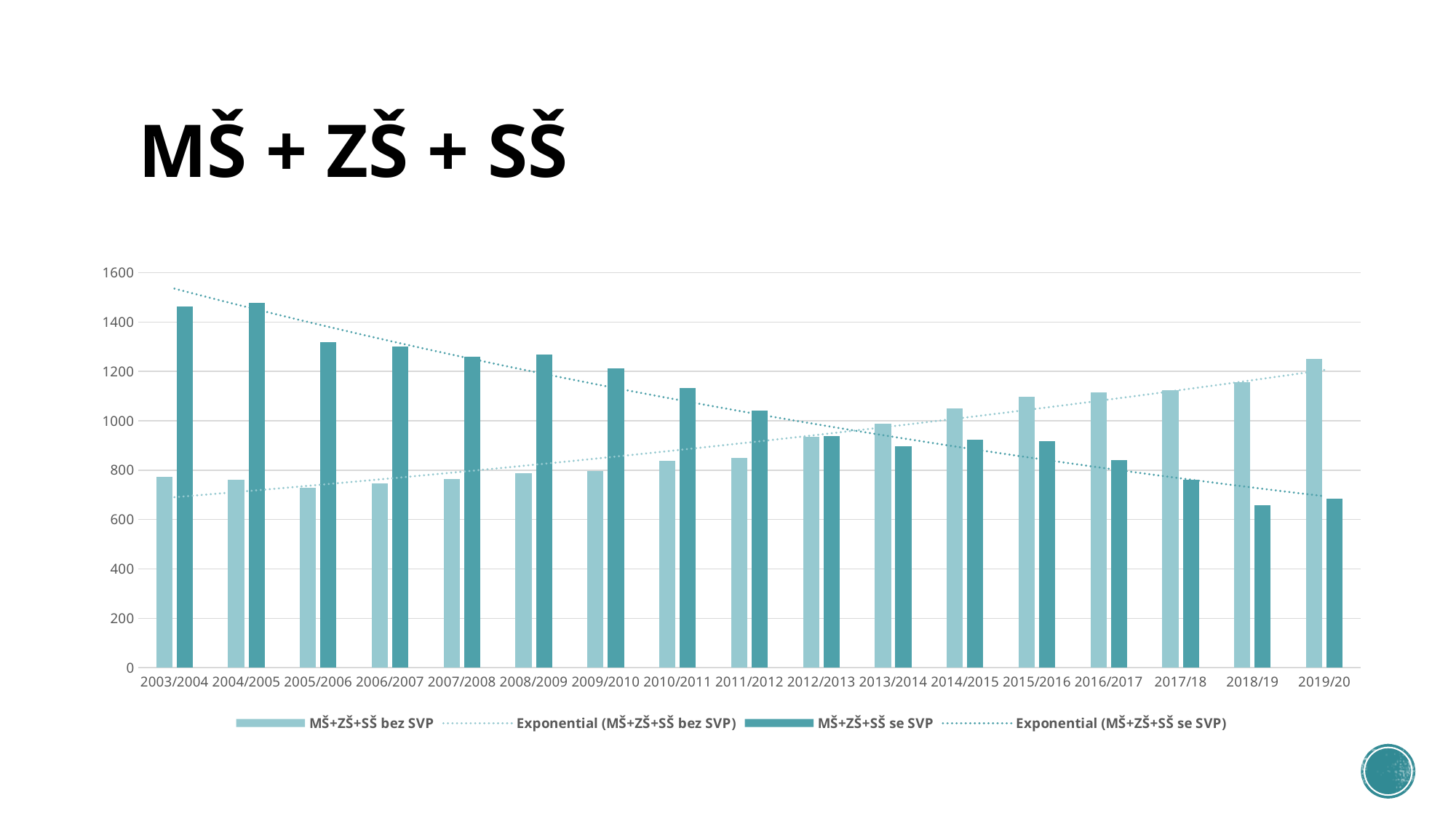
Which school year has the highest value for MŠ+ZŠ+SŠ bez SVP? 2019/20 Is the value for MŠ+ZŠ+SŠ bez SVP in 2014/2015 greater or less than 1000? greater How many entries does the legend list? 4 What kind of chart is shown on the slide? bar chart Do the values for MŠ+ZŠ+SŠ se SVP generally rise or fall from 2003/2004 to 2019/20? fall Is the value for MŠ+ZŠ+SŠ se SVP in 2018/19 greater or less than 800? less In 2003/2004, which series has the larger value: MŠ+ZŠ+SŠ bez SVP or MŠ+ZŠ+SŠ se SVP? MŠ+ZŠ+SŠ se SVP Is the value for MŠ+ZŠ+SŠ bez SVP in 2003/2004 greater or less than 800? less How many school-year categories are shown on the x axis? 17 In 2019/20, which series has the larger value: MŠ+ZŠ+SŠ bez SVP or MŠ+ZŠ+SŠ se SVP? MŠ+ZŠ+SŠ bez SVP